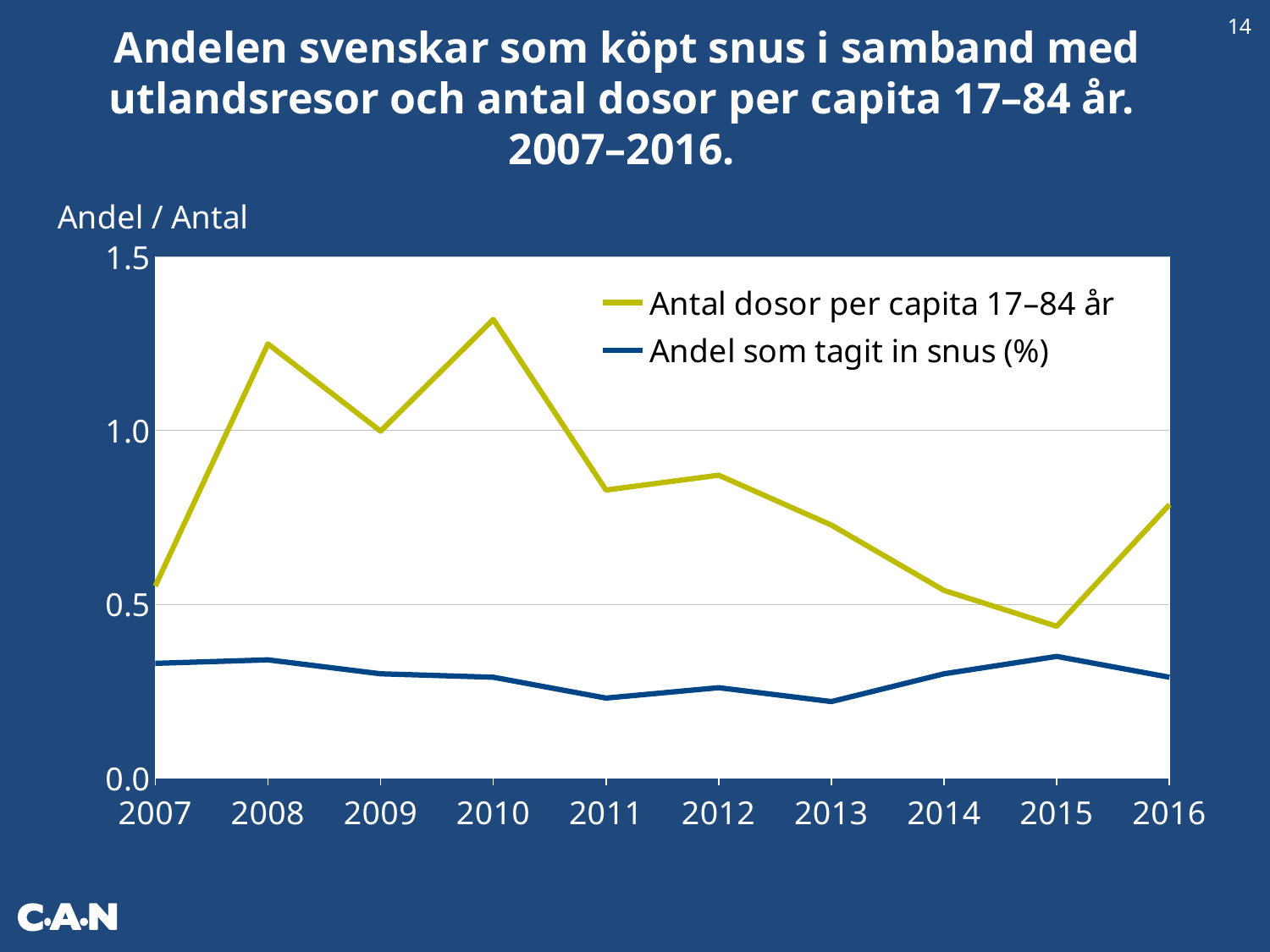
Which series has the higher value in 2010, 'Antal dosor per capita 17–84 år' or 'Andel som tagit in snus (%)'? Antal dosor per capita 17–84 år What label is shown above the y axis? Andel / Antal How many series does the legend list? 2 Does the 'Antal dosor per capita 17–84 år' line rise or fall from 2010 to 2015? fall Is the value for 'Antal dosor per capita 17–84 år' in 2015 greater or less than 0.5? less Is the value for 'Andel som tagit in snus (%)' in 2011 greater or less than 0.5? less Which series is drawn in blue? Andel som tagit in snus (%) In which year is the value for 'Antal dosor per capita 17–84 år' lowest? 2015 Is the value for 'Antal dosor per capita 17–84 år' in 2008 greater or less than 1.0? greater In which year is the value for 'Antal dosor per capita 17–84 år' highest? 2010 What kind of chart is shown on the slide? line chart How many years are plotted along the x axis? 10